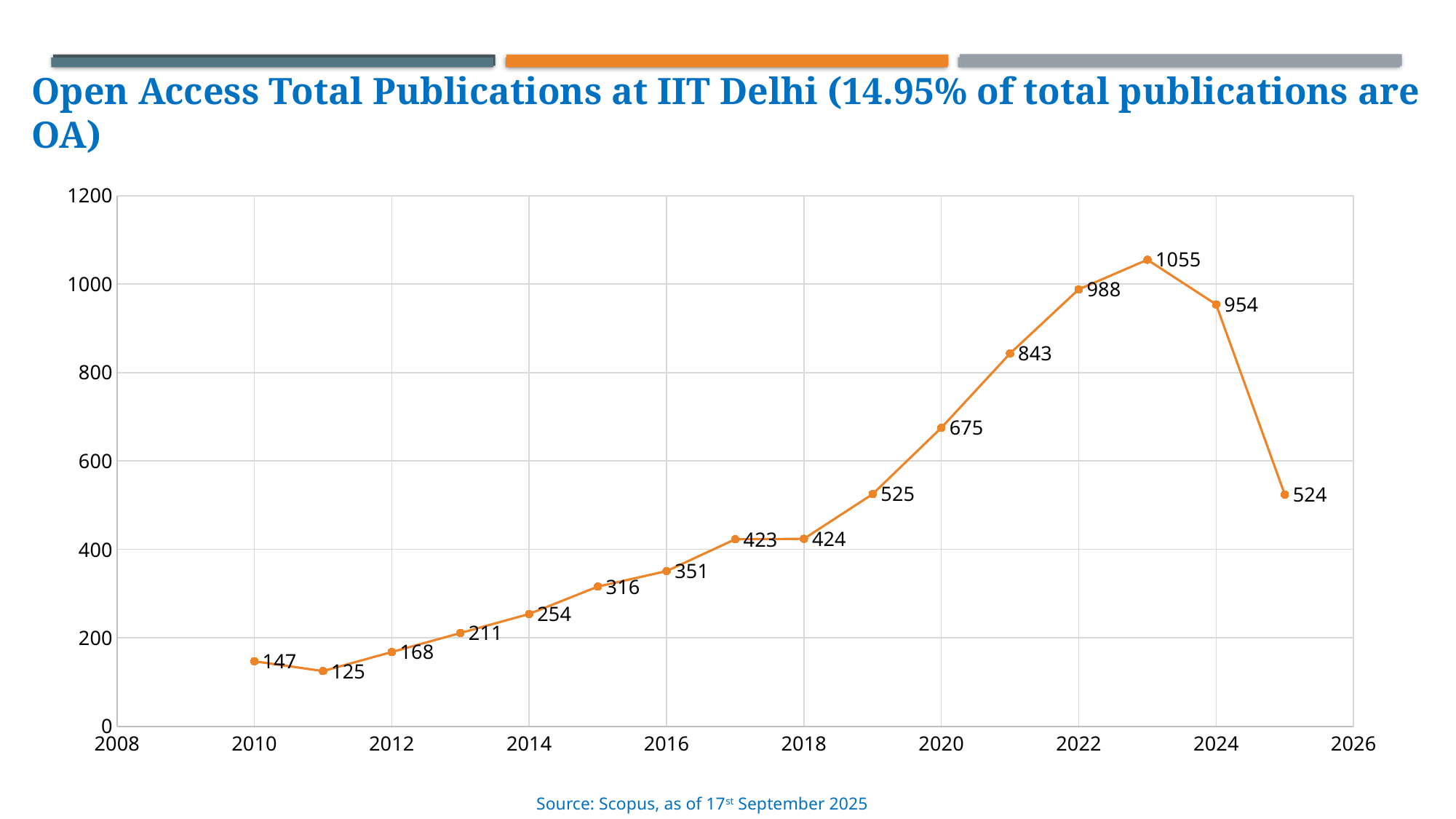
What is the value for 2020? 675 What is the title of the chart? Open Access Total Publications at IIT Delhi (14.95% of total publications are OA) What is the value for 2010? 147 What is the highest value plotted on the chart? 1055 What is the lowest value plotted on the chart? 125 How many data points are plotted on the chart? 16 What type of chart is shown on the slide? line chart Do the values generally rise or fall from 2012 to 2022? rise What is the difference between the values for 2022 and 2020? 313 Which is larger, the value for 2018 or the value for 2025? 2025 What is the value for 2024? 954 What is the value for 2016? 351